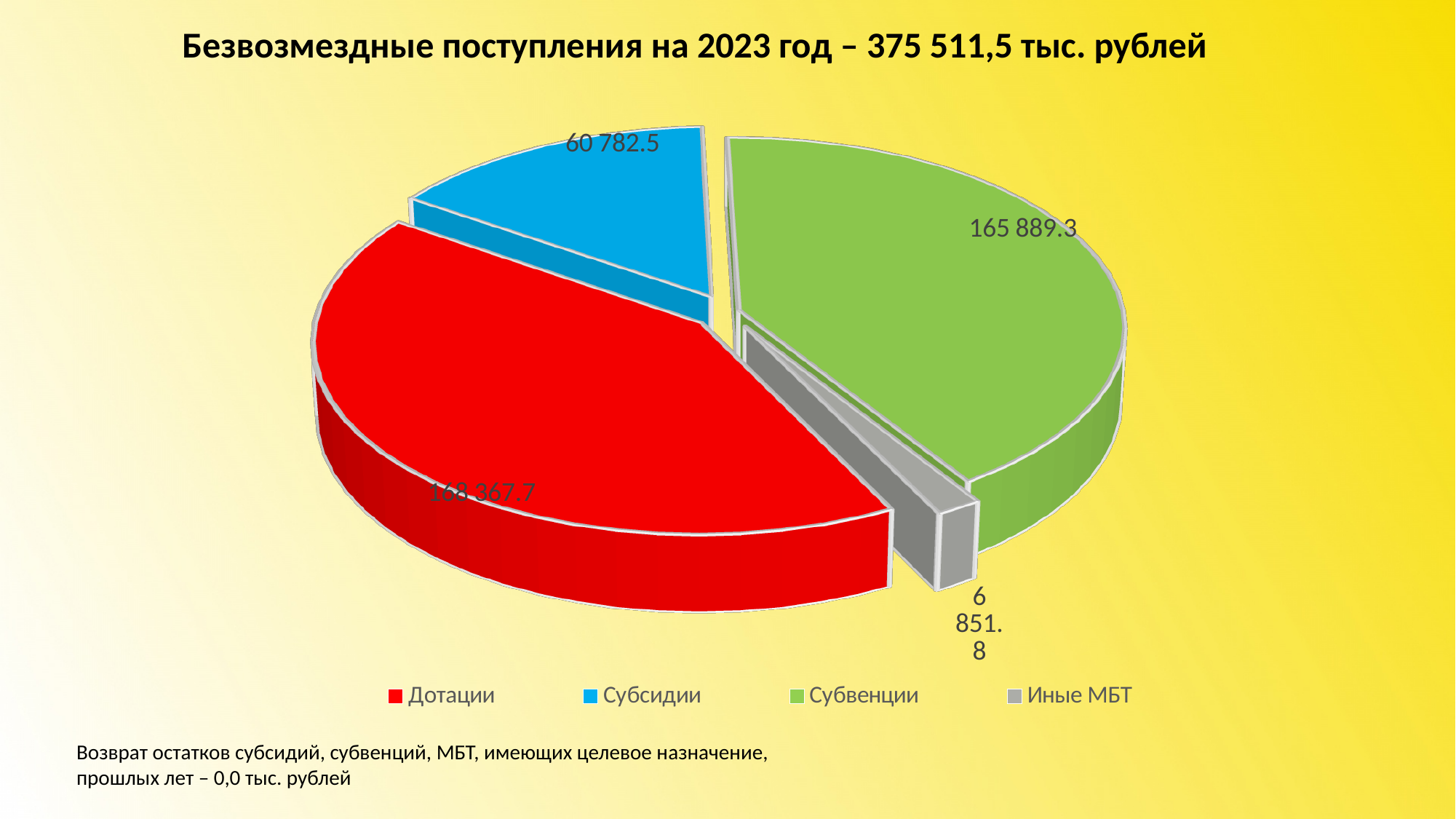
Which category has the smallest slice? Иные МБТ What is the value for Субвенции? 165 889.3 What is the difference between the values for Субвенции and Субсидии? 105 106.8 What is the value for Субсидии? 60 782.5 What kind of chart is shown on the slide? Pie chart What is the value for Иные МБТ? 6 851.8 What colour is the Субвенции slice? Green Which is larger, Субсидии or Иные МБТ? Субсидии Which category has the largest slice? Дотации What is the value for Дотации? 168 367.7 What is the difference between the values for Дотации and Субвенции? 2 478.4 How many slices does the pie chart have? 4